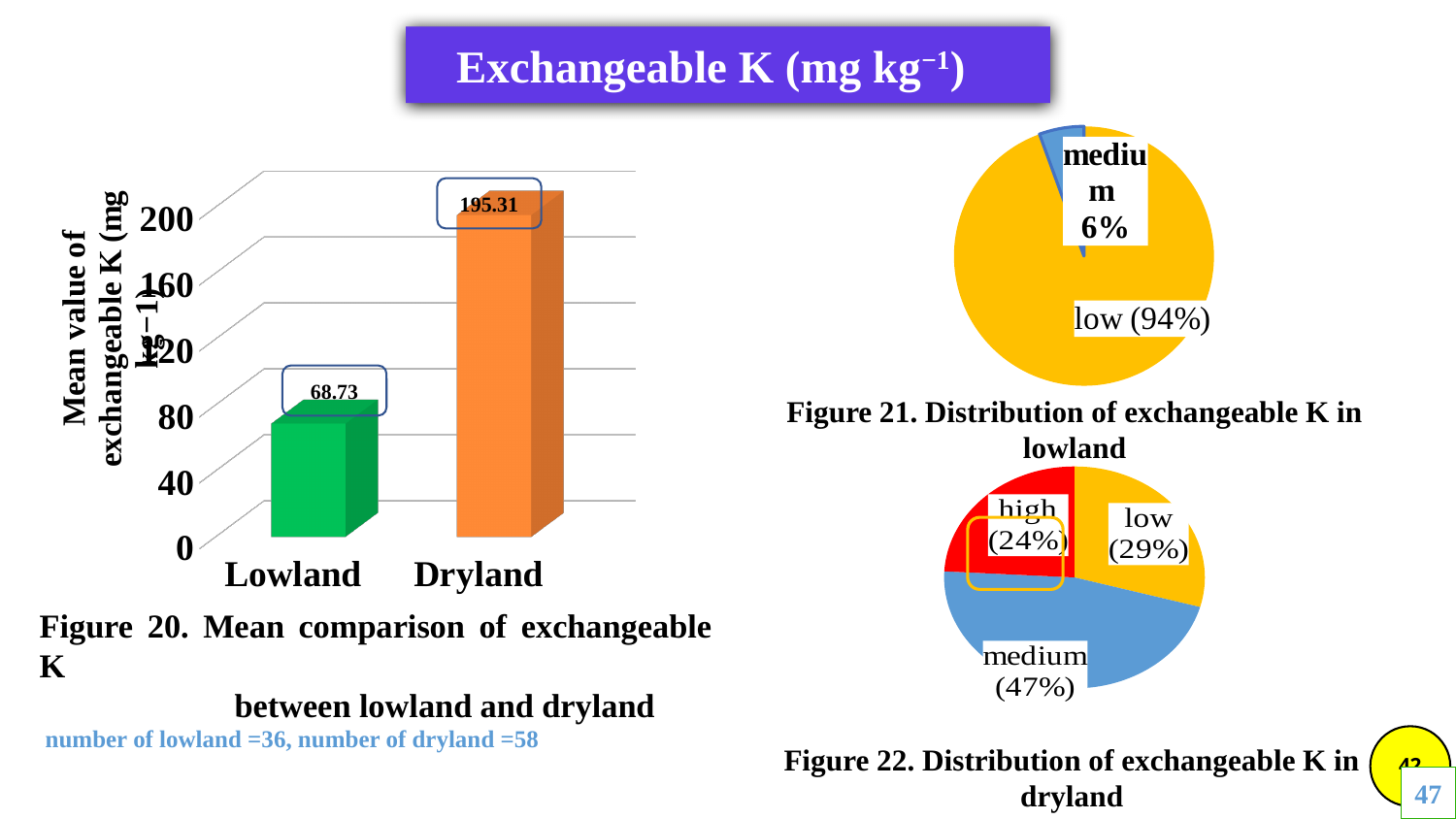
In the pie chart for dryland (Figure 22), which category has the smallest share? high In the pie chart for dryland (Figure 22), which is larger: the low share or the high share? low In the pie chart for dryland (Figure 22), what share is the medium category? 47% In the pie chart for dryland (Figure 22), how many slices are there? 3 In the bar chart (Figure 20), what is the difference between the Dryland and Lowland mean values? 126.58 In the bar chart (Figure 20), what is the mean value of exchangeable K for Dryland? 195.31 In the bar chart (Figure 20), how many categories are plotted? 2 In the bar chart (Figure 20), what is the mean value of exchangeable K for Lowland? 68.73 What type of chart is Figure 20? Bar chart In the bar chart (Figure 20), which category has the higher mean value of exchangeable K? Dryland In the pie chart for lowland (Figure 21), what share is the medium category? 6% In the pie chart for lowland (Figure 21), what share is the low category? 94%